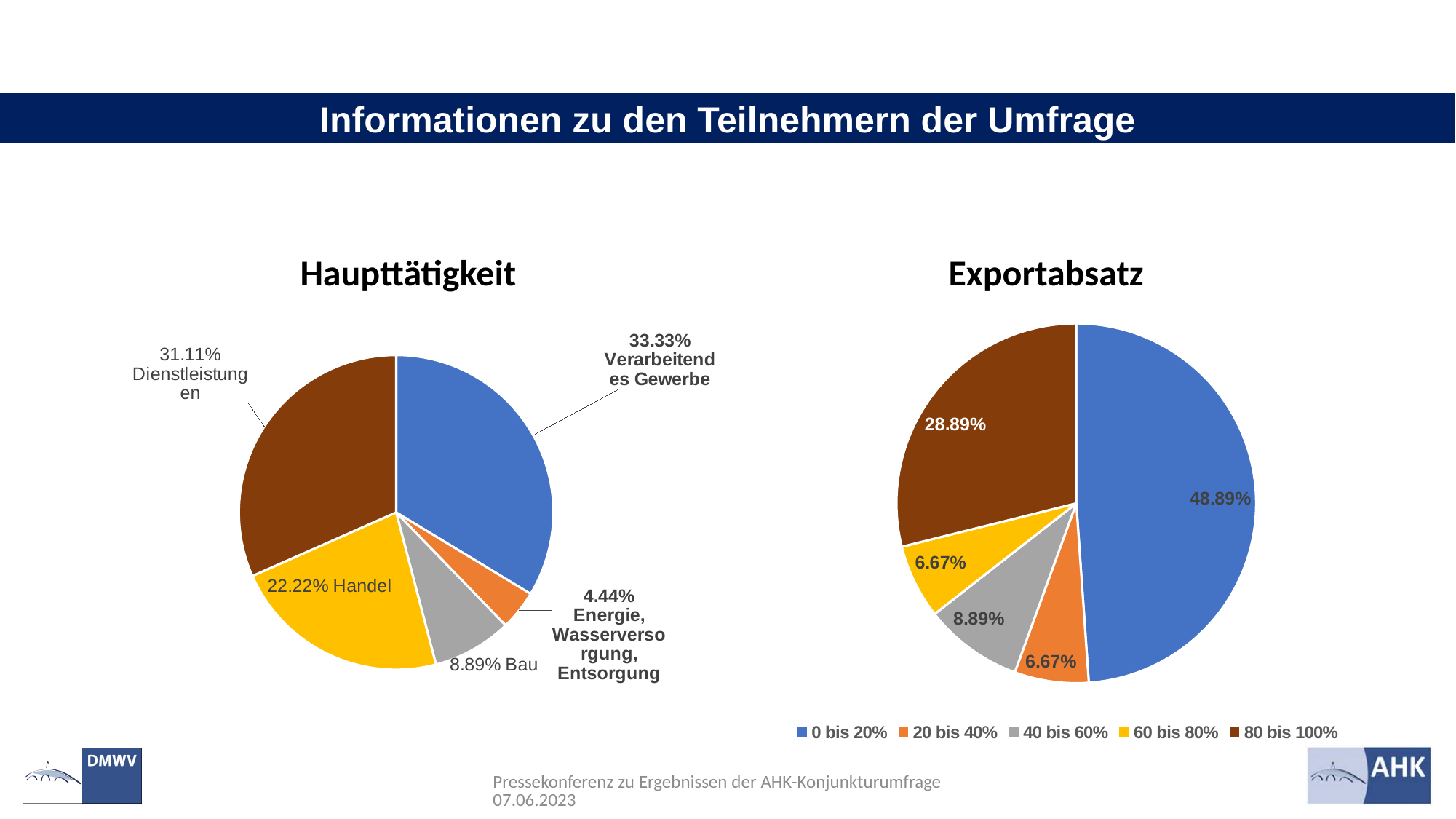
In the Haupttätigkeit chart, what share is Handel? 22.22% In the Exportabsatz chart, what share is the 0 bis 20% category? 48.89% In the Haupttätigkeit chart, which category has the largest share? Verarbeitendes Gewerbe What kind of chart is the Exportabsatz chart? Pie chart In the Haupttätigkeit chart, which category has the smallest share? Energie, Wasserversorgung, Entsorgung In the Haupttätigkeit chart, what is the difference between the shares of Dienstleistungen and Handel? 8.89% In the Haupttätigkeit chart, how many categories are shown? 5 How many entries does the legend of the Exportabsatz chart list? 5 In the Exportabsatz chart, which category has the largest share? 0 bis 20% In the Haupttätigkeit chart, what share is Verarbeitendes Gewerbe? 33.33% In the Exportabsatz chart, which is larger: 40 bis 60% or 80 bis 100%? 80 bis 100% In the Exportabsatz chart, what share is the 80 bis 100% category? 28.89%